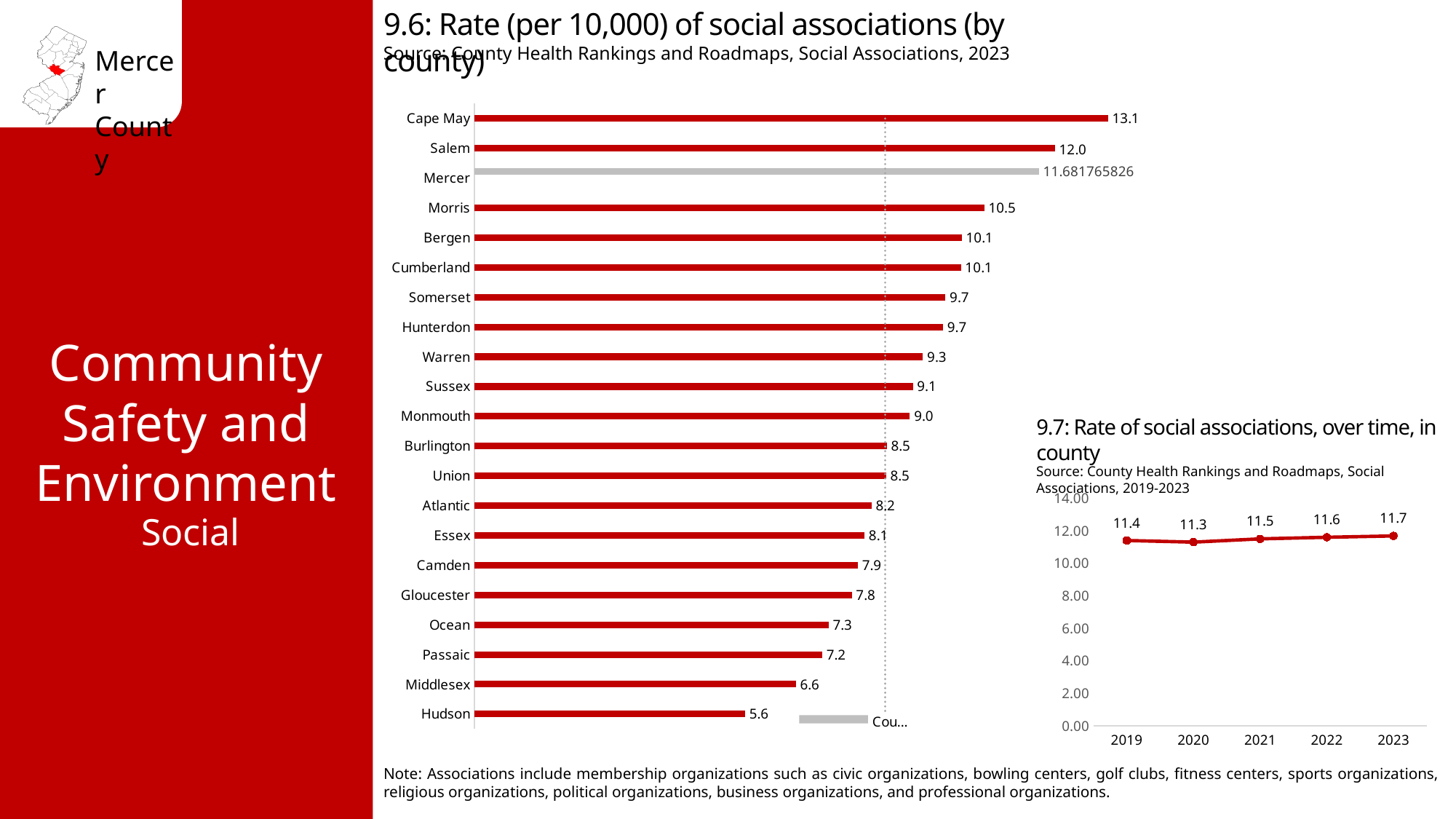
In chart 9.7 (rate of social associations over time), how many years are plotted? 5 What kind of chart is chart 9.6 (rate of social associations by county)? Bar chart In chart 9.6 (rate of social associations by county), which is larger, the value for Warren or the value for Camden? Warren In chart 9.6 (rate of social associations by county), what is the value for Hudson? 5.6 In chart 9.6 (rate of social associations by county), what is the value for Cape May? 13.1 In chart 9.7 (rate of social associations over time), what is the value for 2023? 11.7 In chart 9.6 (rate of social associations by county), which county has the highest rate? Cape May In chart 9.6 (rate of social associations by county), what is the value shown for Mercer? 11.681765826 In chart 9.6 (rate of social associations by county), how many counties are shown? 21 In chart 9.7 (rate of social associations over time), which year has the lowest value? 2020 In chart 9.6 (rate of social associations by county), which county has the lowest rate? Hudson In chart 9.6 (rate of social associations by county), what is the difference between Salem and Morris? 1.5